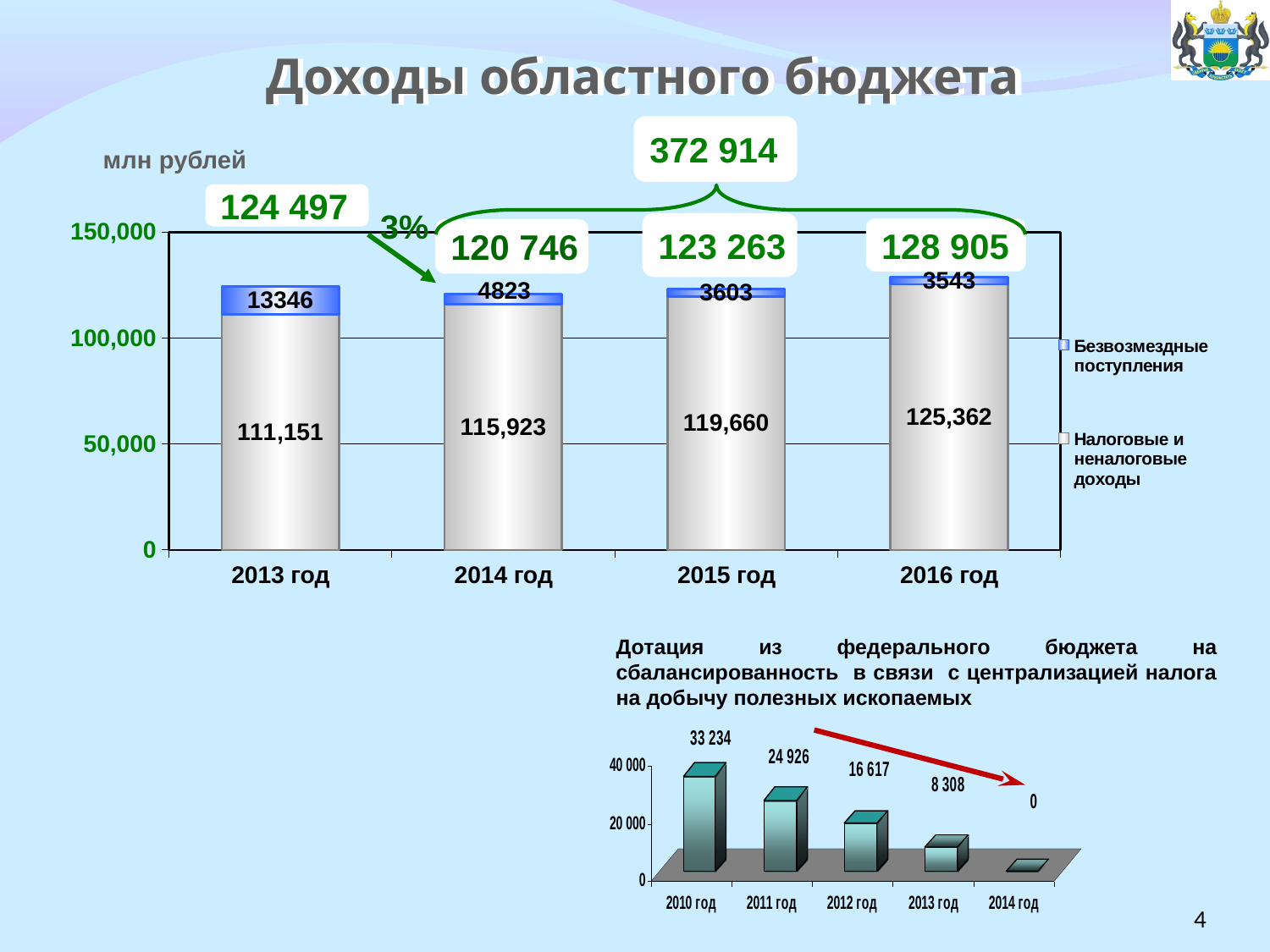
In the main chart 'Доходы областного бюджета', what unit is shown for the values? млн рублей In the main chart 'Доходы областного бюджета', do the values of 'Налоговые и неналоговые доходы' rise or fall from 2013 год to 2016 год? rise In the bottom chart about 'Дотация из федерального бюджета', what is the value for 2011 год? 24 926 In the main chart 'Доходы областного бюджета', what is the total shown above the bar for 2016 год? 128 905 In the bottom chart about 'Дотация из федерального бюджета', how many years are shown on the x axis? 5 In the main chart 'Доходы областного бюджета', which year has the highest value of 'Безвозмездные поступления'? 2013 год In the main chart 'Доходы областного бюджета', what is the value of 'Безвозмездные поступления' for 2013 год? 13346 In the bottom chart about 'Дотация из федерального бюджета', what is the difference between the values for 2010 год and 2013 год? 24 926 In the main chart 'Доходы областного бюджета', what is the value of 'Налоговые и неналоговые доходы' for 2014 год? 115,923 In the main chart 'Доходы областного бюджета', what is the difference between 'Налоговые и неналоговые доходы' in 2016 год and 2015 год? 5,702 In the main chart 'Доходы областного бюджета', which year has the lowest value of 'Налоговые и неналоговые доходы'? 2013 год In the main chart 'Доходы областного бюджета', how many series does the legend list? 2